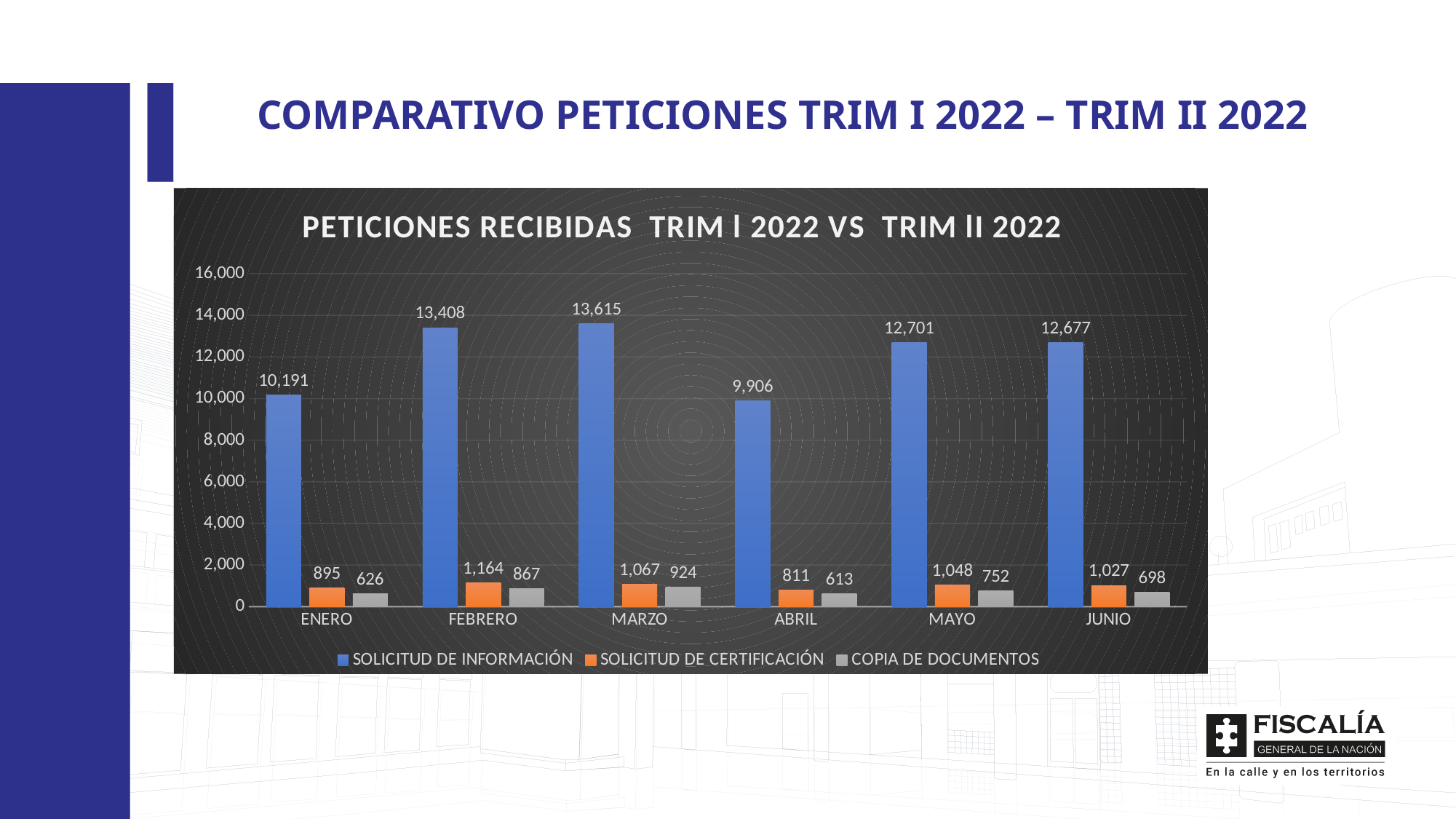
Which is larger, the SOLICITUD DE CERTIFICACIÓN value for MAYO or for JUNIO? MAYO What is the title of the chart? PETICIONES RECIBIDAS TRIM I 2022 VS TRIM II 2022 What is the value for COPIA DE DOCUMENTOS in ABRIL? 613 Is the value for SOLICITUD DE INFORMACIÓN in ABRIL greater or less than 10,000? less Which month has the lowest value for COPIA DE DOCUMENTOS? ABRIL What kind of chart is shown? bar chart What is the value for SOLICITUD DE INFORMACIÓN in MARZO? 13,615 How many months are shown on the x axis? 6 Which month has the highest value for SOLICITUD DE INFORMACIÓN? MARZO What is the value for SOLICITUD DE CERTIFICACIÓN in FEBRERO? 1,164 What is the difference between the SOLICITUD DE INFORMACIÓN values for FEBRERO and ENERO? 3,217 How many series does the legend list? 3